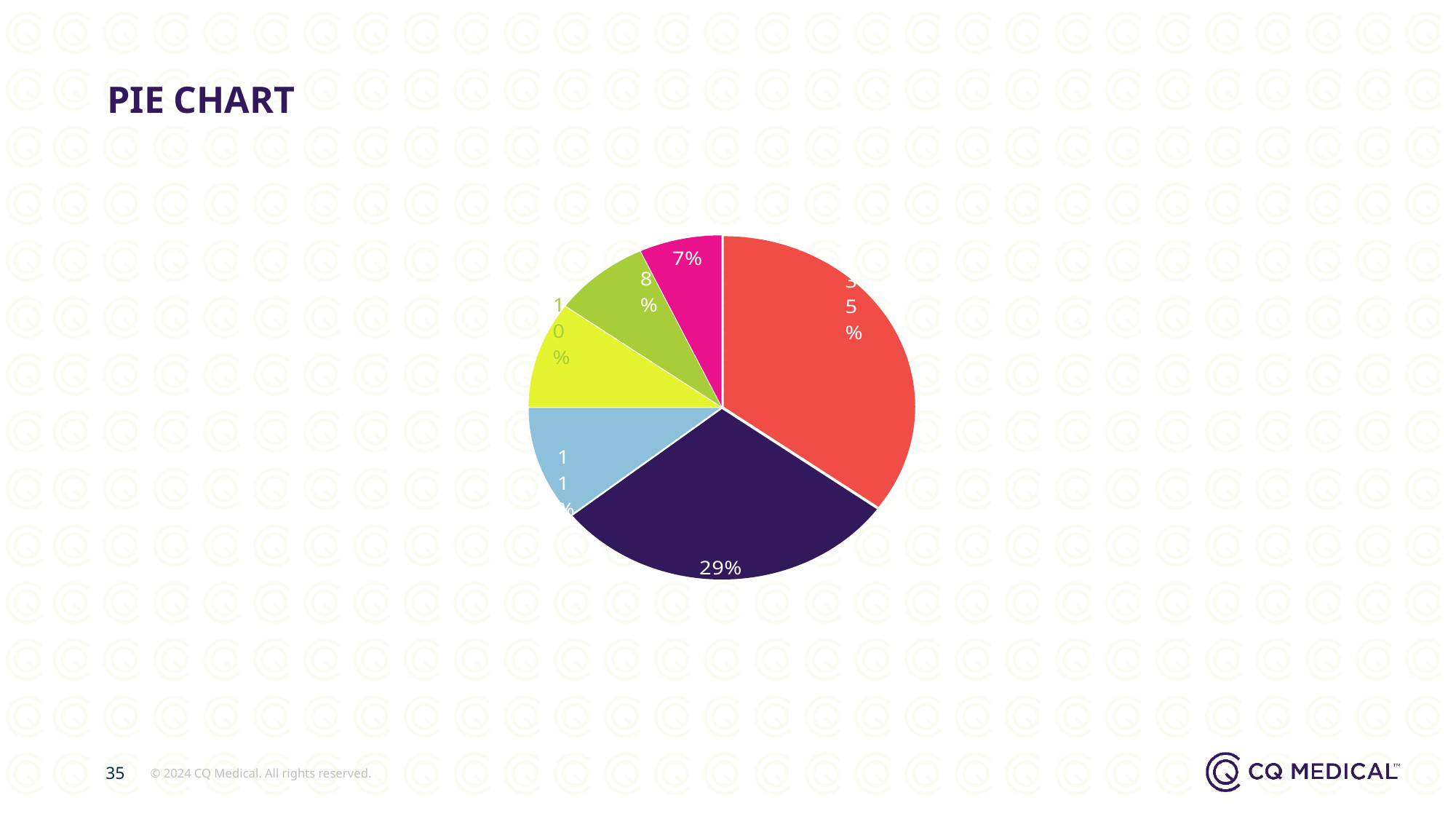
What percentage is shown on the dark purple slice of the pie chart? 29% Which slice of the pie chart is the smallest? the magenta slice (7%) Which is larger in the pie chart, the green slice or the magenta slice? the green slice What is the title of the chart on the slide? PIE CHART Which slice of the pie chart is the largest? the red slice (35%) What percentage is shown on the red slice of the pie chart? 35% How many slices does the pie chart have? 6 What kind of chart is shown on the slide? pie chart What percentage is shown on the magenta slice of the pie chart? 7% What is the difference between the red slice and the dark purple slice of the pie chart? 6% What percentage is shown on the yellow-green slice of the pie chart? 10% What percentage is shown on the green slice of the pie chart? 8%